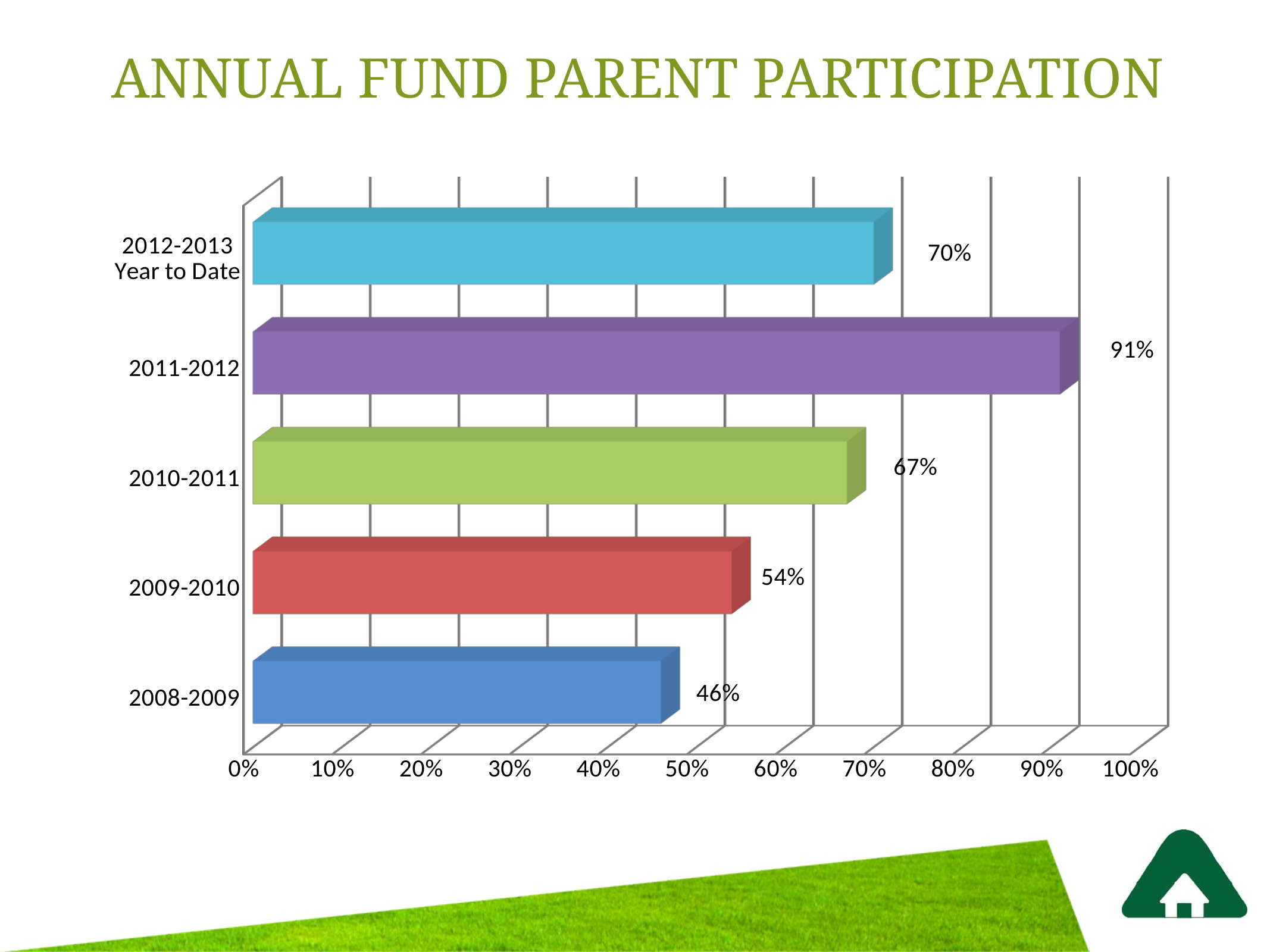
What is the value shown for 2012-2013 Year to Date? 70% What is the difference between the 2009-2010 value and the 2008-2009 value? 8% What is the difference between the 2011-2012 value and the 2010-2011 value? 24% What is the parent participation value for 2011-2012? 91% Is the value for 2009-2010 greater or less than 50%? greater Which is larger, the value for 2010-2011 or the value for 2012-2013 Year to Date? 2012-2013 Year to Date What kind of chart is shown on the slide? bar chart What is the title of the slide? ANNUAL FUND PARENT PARTICIPATION How many years (categories) are shown on the chart? 5 Which year has the lowest parent participation? 2008-2009 Which year has the highest parent participation? 2011-2012 What is the parent participation value for 2008-2009? 46%